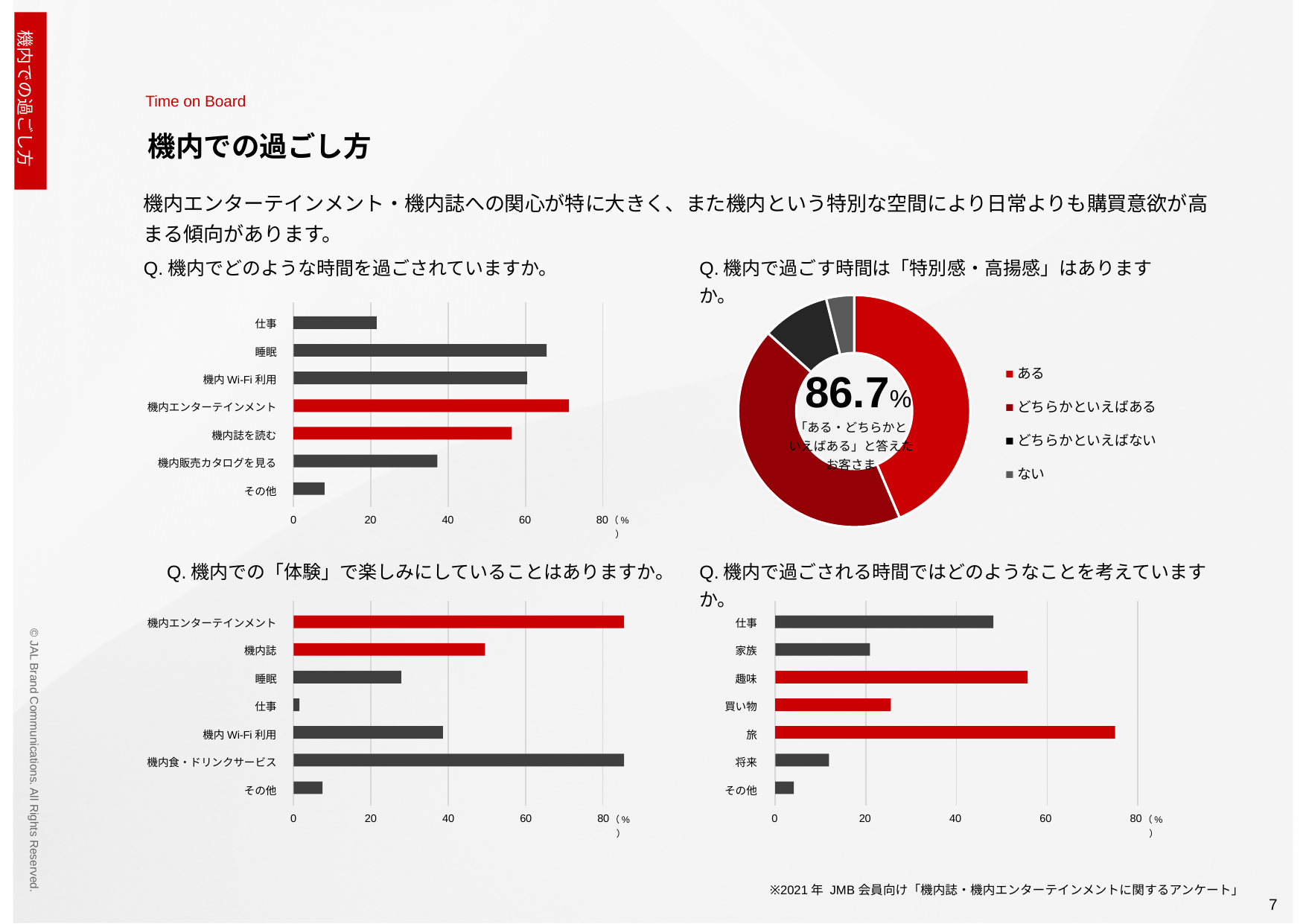
In the top-left chart 'Q. 機内でどのような時間を過ごされていますか。', how many categories are plotted? 7 In the top-left chart 'Q. 機内でどのような時間を過ごされていますか。', which category has the lowest value? その他 How many entries does the legend of the top-right donut chart list? 4 In the bottom-left chart 'Q. 機内での「体験」で楽しみにしていることはありますか。', is the value for 機内誌 greater or less than 40? greater In the bottom-right chart 'Q. 機内で過ごされる時間ではどのようなことを考えていますか。', which category has the highest value? 旅 In the top-left chart 'Q. 機内でどのような時間を過ごされていますか。', is the value for 睡眠 greater or less than 60? greater In the top-right donut chart, what percentage is printed in the centre? 86.7% In the bottom-left chart 'Q. 機内での「体験」で楽しみにしていることはありますか。', which category has the lowest value? 仕事 What kind of chart is used for 'Q. 機内でどのような時間を過ごされていますか。' (top-left)? bar chart In the top-left chart 'Q. 機内でどのような時間を過ごされていますか。', which category has the highest value? 機内エンターテインメント What kind of chart is used for 'Q. 機内で過ごす時間は「特別感・高揚感」はありますか。' (top-right)? donut chart In the bottom-right chart 'Q. 機内で過ごされる時間ではどのようなことを考えていますか。', which is larger, 仕事 or 家族? 仕事